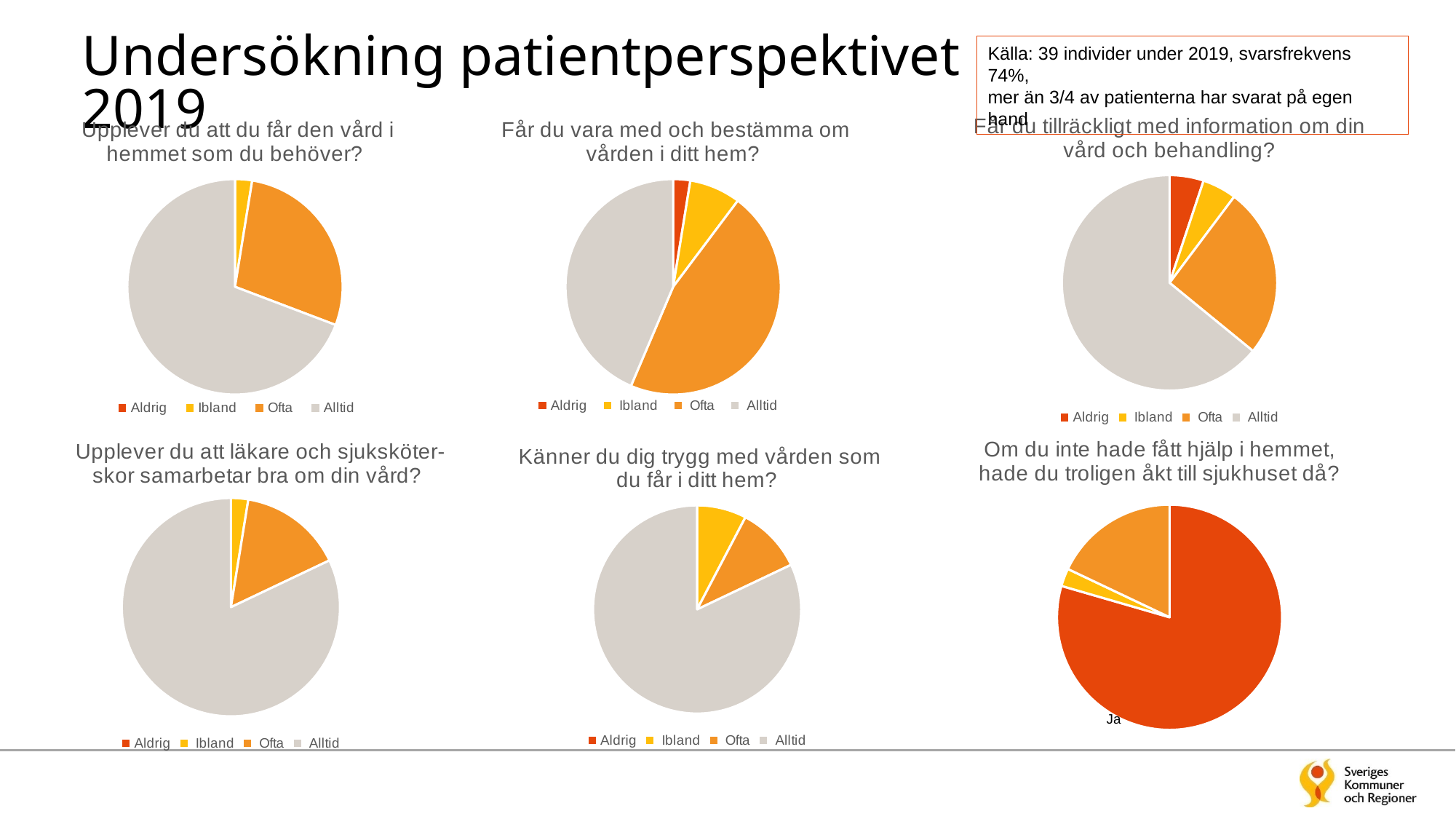
In the chart "Känner du dig trygg med vården som du får i ditt hem?", which category has the largest slice? Alltid In the chart "Får du vara med och bestämma om vården i ditt hem?", which category has the largest slice? Ofta In the chart "Upplever du att du får den vård i hemmet som du behöver?", which category has the largest slice? Alltid How many pie charts are shown on the slide? 6 In the chart "Får du vara med och bestämma om vården i ditt hem?", which category has the smallest slice? Aldrig In the chart "Upplever du att läkare och sjuksköterskor samarbetar bra om din vård?", which slice is larger, Ofta or Ibland? Ofta What are the four legend entries in the chart "Känner du dig trygg med vården som du får i ditt hem?"? Aldrig, Ibland, Ofta, Alltid In the chart "Upplever du att du får den vård i hemmet som du behöver?", how many entries does the legend list? 4 What kind of chart is used for "Upplever du att du får den vård i hemmet som du behöver?"? Pie chart In the chart "Får du vara med och bestämma om vården i ditt hem?", which slice is larger, Ofta or Alltid? Ofta